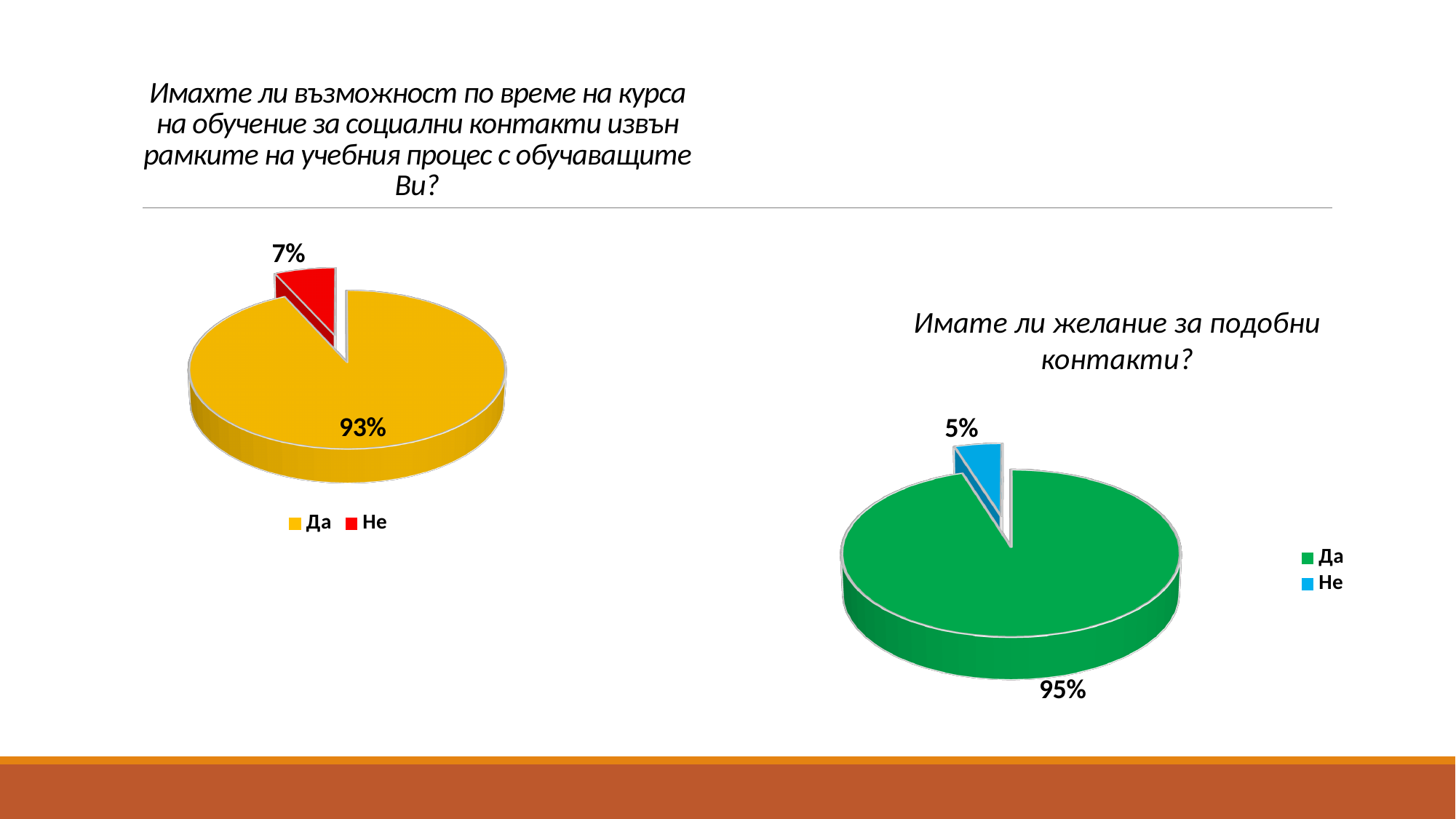
In the right pie chart, which category has the smallest slice? Не In the right pie chart ("Имате ли желание за подобни контакти?"), what percentage is shown for "Да"? 95% In the right pie chart, what is the difference in percentage points between "Да" and "Не"? 90 In the left pie chart, what is the difference in percentage points between "Да" and "Не"? 86 What type of chart is used on the right side of the slide? Pie chart Which is larger: the "Не" share in the left pie chart or the "Не" share in the right pie chart? Left pie chart (7%) How many slices does the left pie chart have? 2 In the right pie chart ("Имате ли желание за подобни контакти?"), what percentage is shown for "Не"? 5% In the right pie chart, what colour is the "Не" slice? Blue In the left pie chart, what percentage is shown for "Не"? 7% In the left pie chart, which category has the largest slice? Да In the left pie chart, what percentage is shown for "Да"? 93%